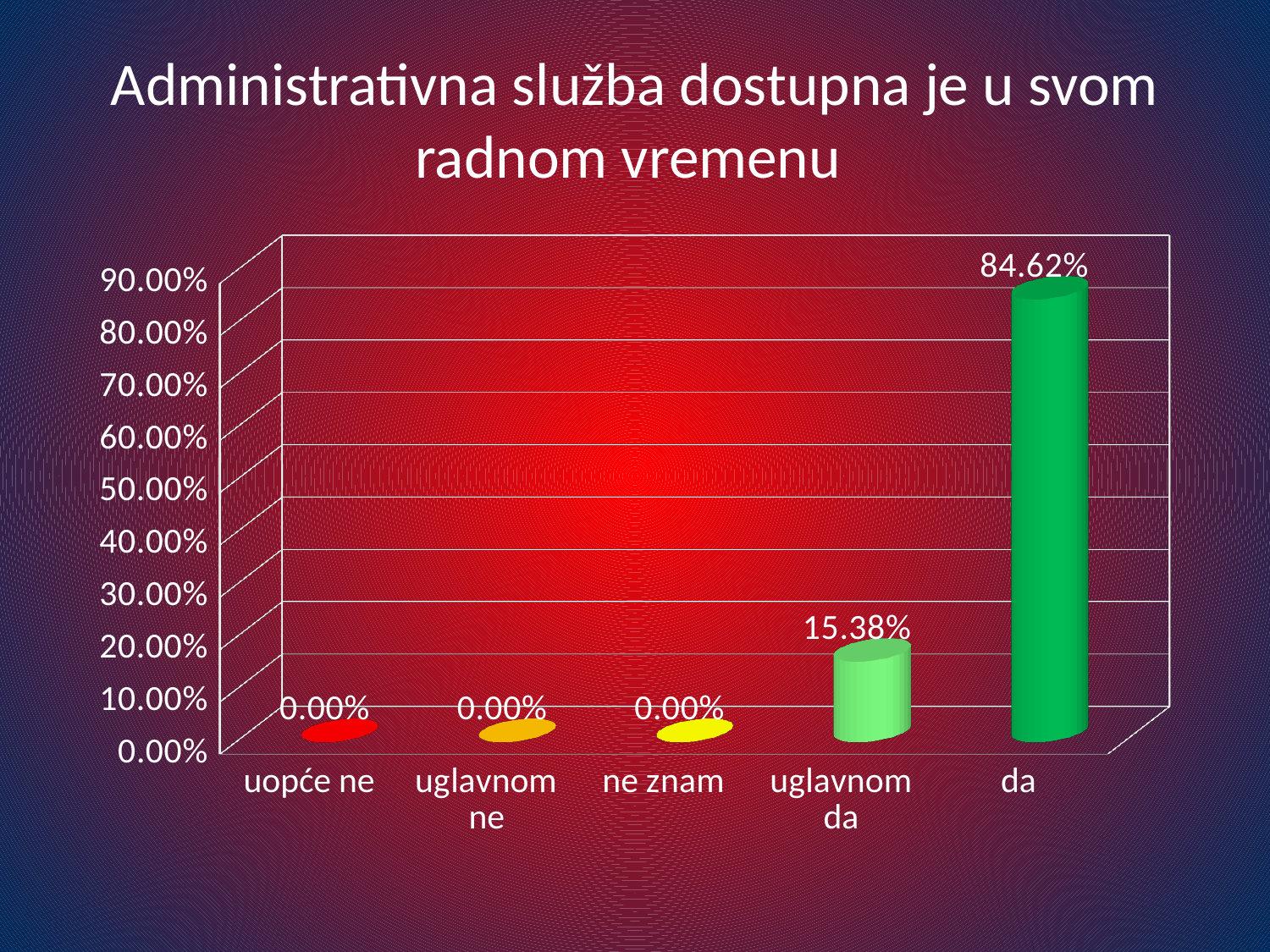
What is the value for "ne znam"? 0.00% What is the title of the chart? Administrativna služba dostupna je u svom radnom vremenu What is the difference between the values for "da" and "uglavnom da"? 69.24% What kind of chart is shown on the slide? bar chart Is the value for "uglavnom da" greater or less than 20.00%? less Which is larger, the value for "uglavnom da" or the value for "da"? da What is the value for "uglavnom da"? 15.38% What is the value for "uopće ne"? 0.00% How many categories are shown on the x axis? 5 What is the value for "da"? 84.62% Which category has the highest value? da Is the value for "da" greater or less than 80.00%? greater